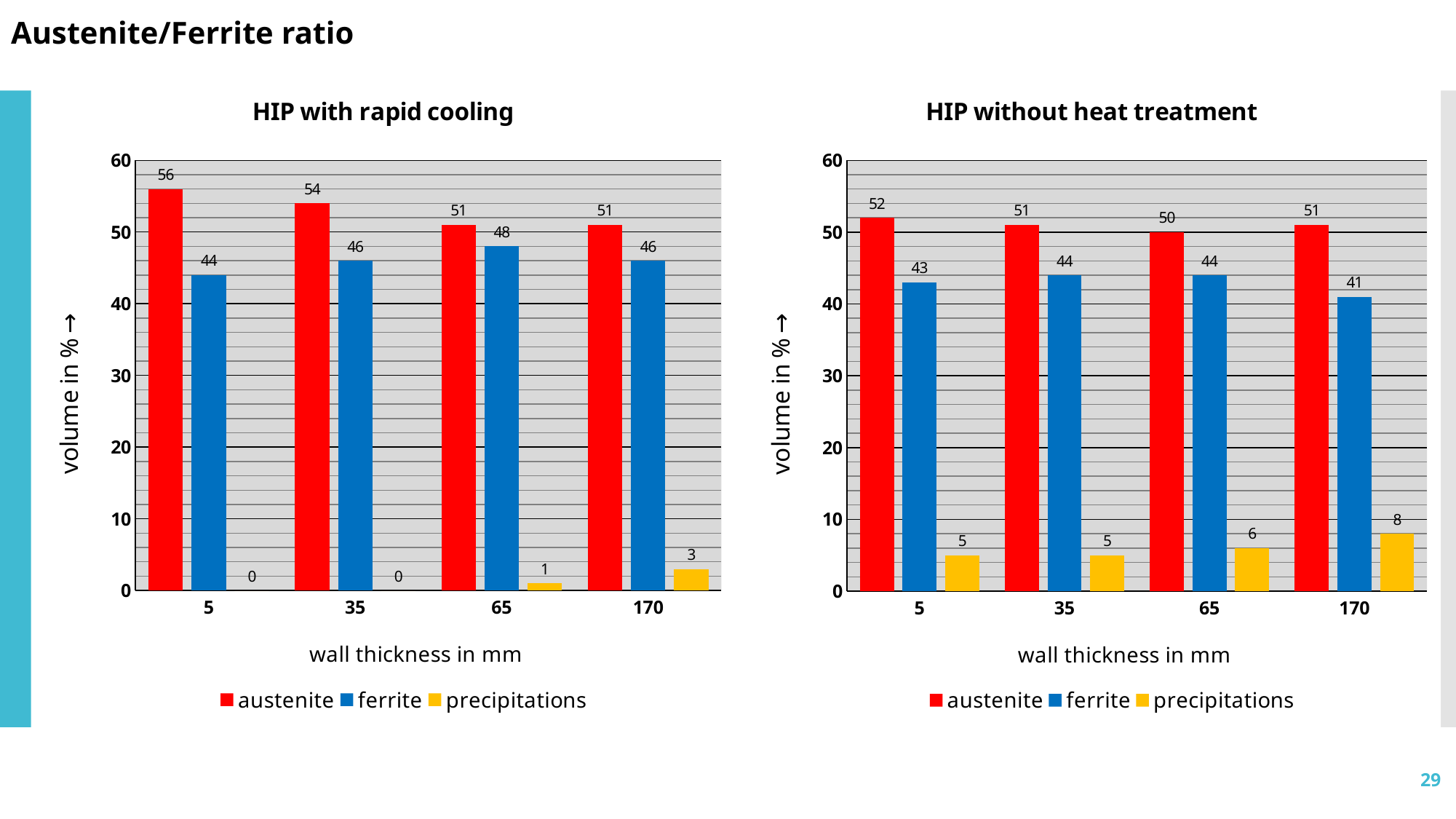
In the 'HIP with rapid cooling' chart, what is the precipitations value at a wall thickness of 65 mm? 1 In the 'HIP with rapid cooling' chart, at which wall thickness is the ferrite value lowest? 5 What kind of chart is the 'HIP with rapid cooling' chart? bar chart In the 'HIP with rapid cooling' chart, what is the austenite value at a wall thickness of 5 mm? 56 In the 'HIP without heat treatment' chart, what is the ferrite value at a wall thickness of 170 mm? 41 In the 'HIP with rapid cooling' chart, does the austenite value rise or fall from a wall thickness of 5 mm to 65 mm? fall In the 'HIP with rapid cooling' chart, what is the difference between the austenite and ferrite values at a wall thickness of 5 mm? 12 In the 'HIP without heat treatment' chart, at which wall thickness is the precipitations value highest? 170 What is the y-axis label of the 'HIP without heat treatment' chart? volume in % → How many wall thickness categories are shown in the 'HIP with rapid cooling' chart? 4 In the 'HIP without heat treatment' chart, which is larger at a wall thickness of 65 mm: austenite or ferrite? austenite How many series does the legend of the 'HIP without heat treatment' chart list? 3